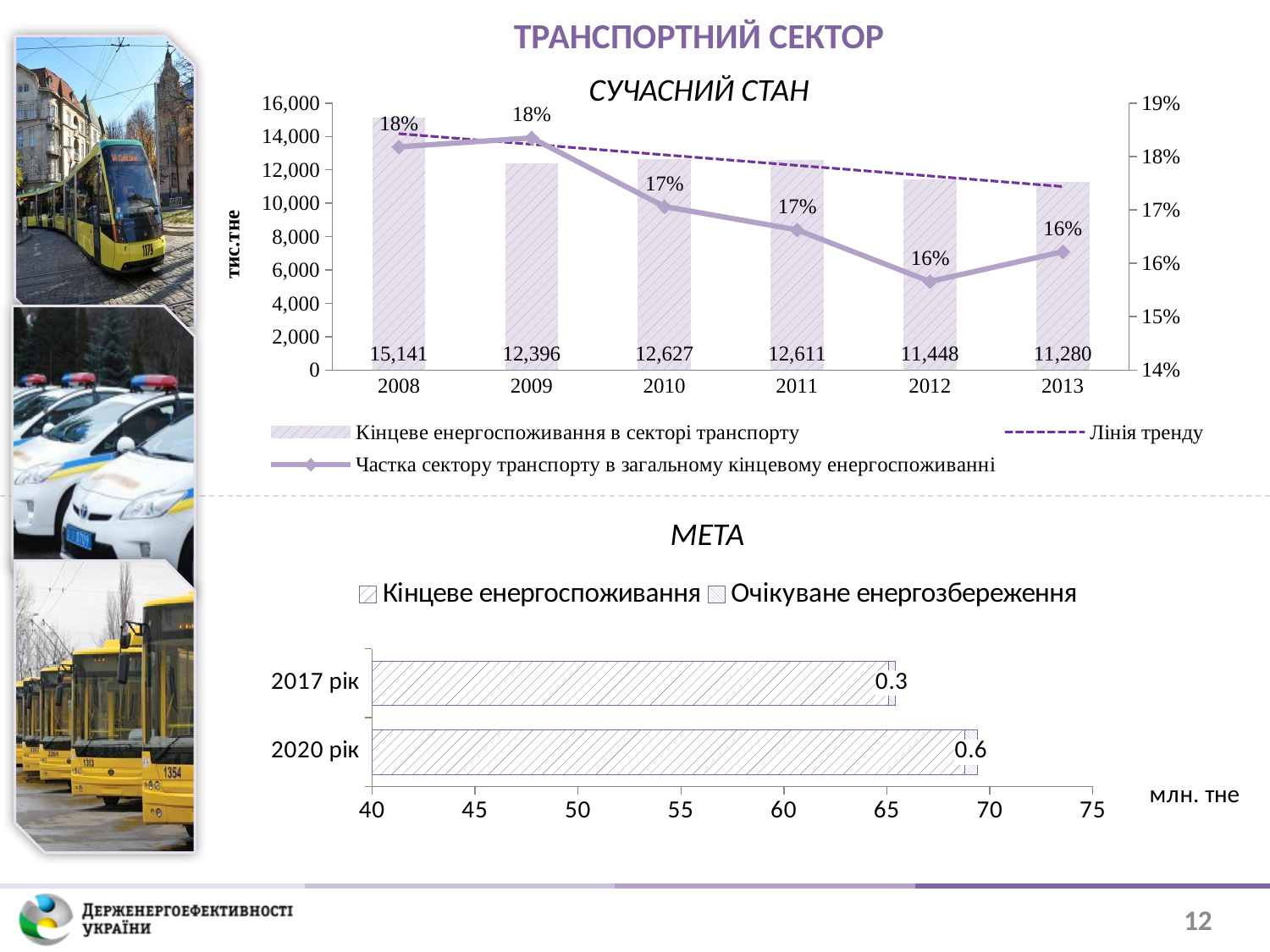
In the top chart (СУЧАСНИЙ СТАН), which year had the highest final energy consumption in the transport sector? 2008 What kind of chart is the bottom chart (МЕТА)? bar chart In the top chart (СУЧАСНИЙ СТАН), what was the final energy consumption in the transport sector in 2008? 15,141 In the bottom chart (МЕТА), what is the expected energy saving (Очікуване енергозбереження) for 2020 рік? 0.6 In the top chart (СУЧАСНИЙ СТАН), does the final energy consumption in the transport sector generally rise or fall from 2008 to 2013? fall In the top chart (СУЧАСНИЙ СТАН), which year had the lowest final energy consumption in the transport sector? 2013 In the top chart (СУЧАСНИЙ СТАН), how many entries does the legend list? 3 In the top chart (СУЧАСНИЙ СТАН), how many years are shown on the x axis? 6 In the top chart (СУЧАСНИЙ СТАН), what was the share of the transport sector in total final energy consumption in 2010? 17% In the top chart (СУЧАСНИЙ СТАН), by how much did final energy consumption in the transport sector fall from 2008 to 2013? 3,861 In the top chart (СУЧАСНИЙ СТАН), what was the final energy consumption in the transport sector in 2012? 11,448 In the bottom chart (МЕТА), is the final energy consumption (Кінцеве енергоспоживання) for 2017 рік greater or less than 60 млн. тне? greater